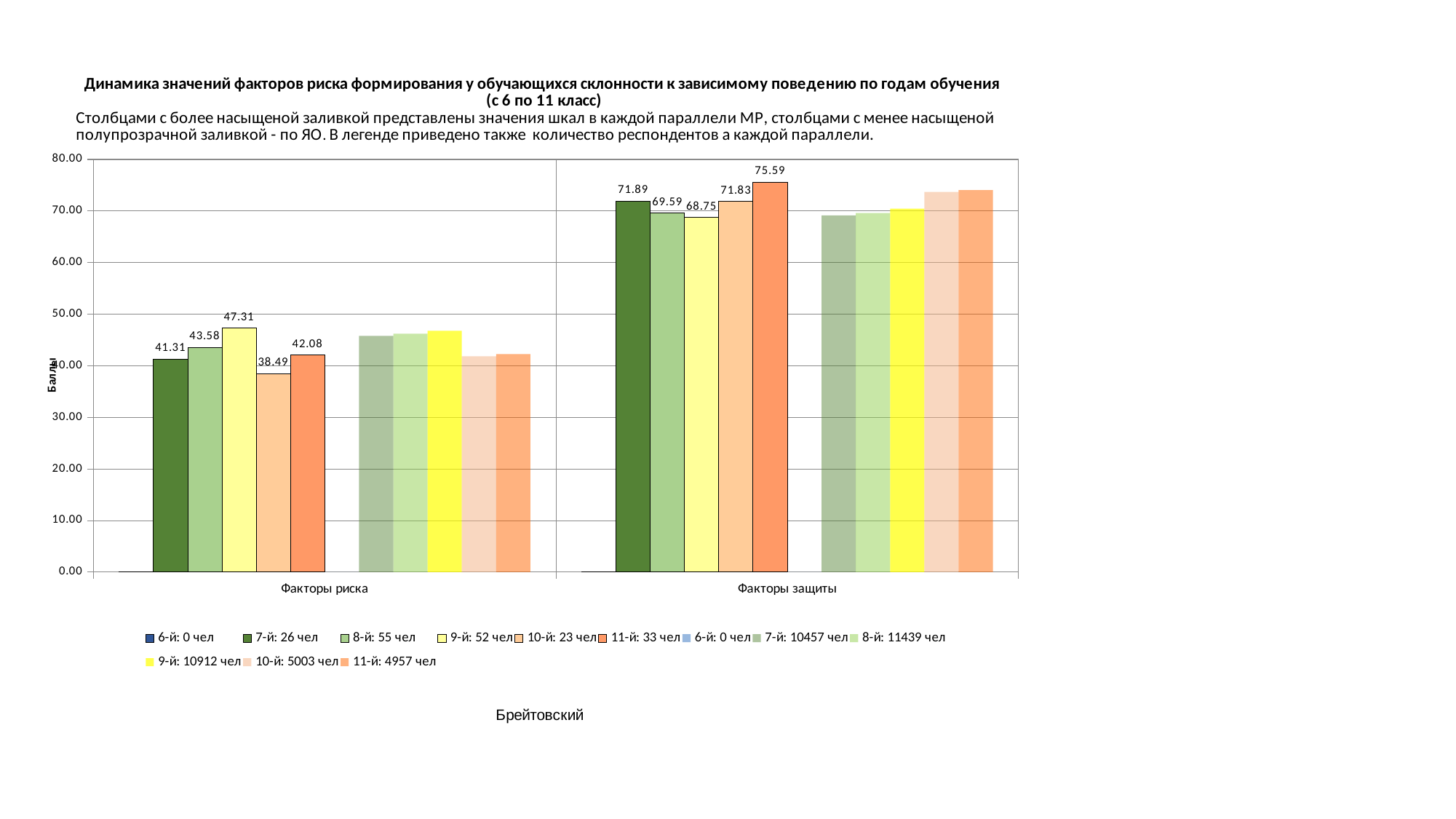
What is the value for the 9-й: 52 чел series in the Факторы риска category? 47.31 Among the labelled bars in the Факторы риска category, which series has the lowest value? 10-й: 23 чел What is the value for the 7-й: 26 чел series in the Факторы риска category? 41.31 How many categories are shown on the x axis? 2 What type of chart is shown on the slide? bar chart What is the value for the 11-й: 33 чел series in the Факторы защиты category? 75.59 Is the value for the 11-й: 4957 чел series in the Факторы защиты category greater or less than 70.00? greater Among the labelled bars in the Факторы защиты category, which series has the highest value? 11-й: 33 чел Which is larger in the Факторы защиты category: the 7-й: 26 чел value or the 8-й: 55 чел value? 7-й: 26 чел What is the value for the 10-й: 23 чел series in the Факторы защиты category? 71.83 What is the difference between the 9-й: 52 чел value and the 10-й: 23 чел value in the Факторы риска category? 8.82 How many series does the legend list? 12